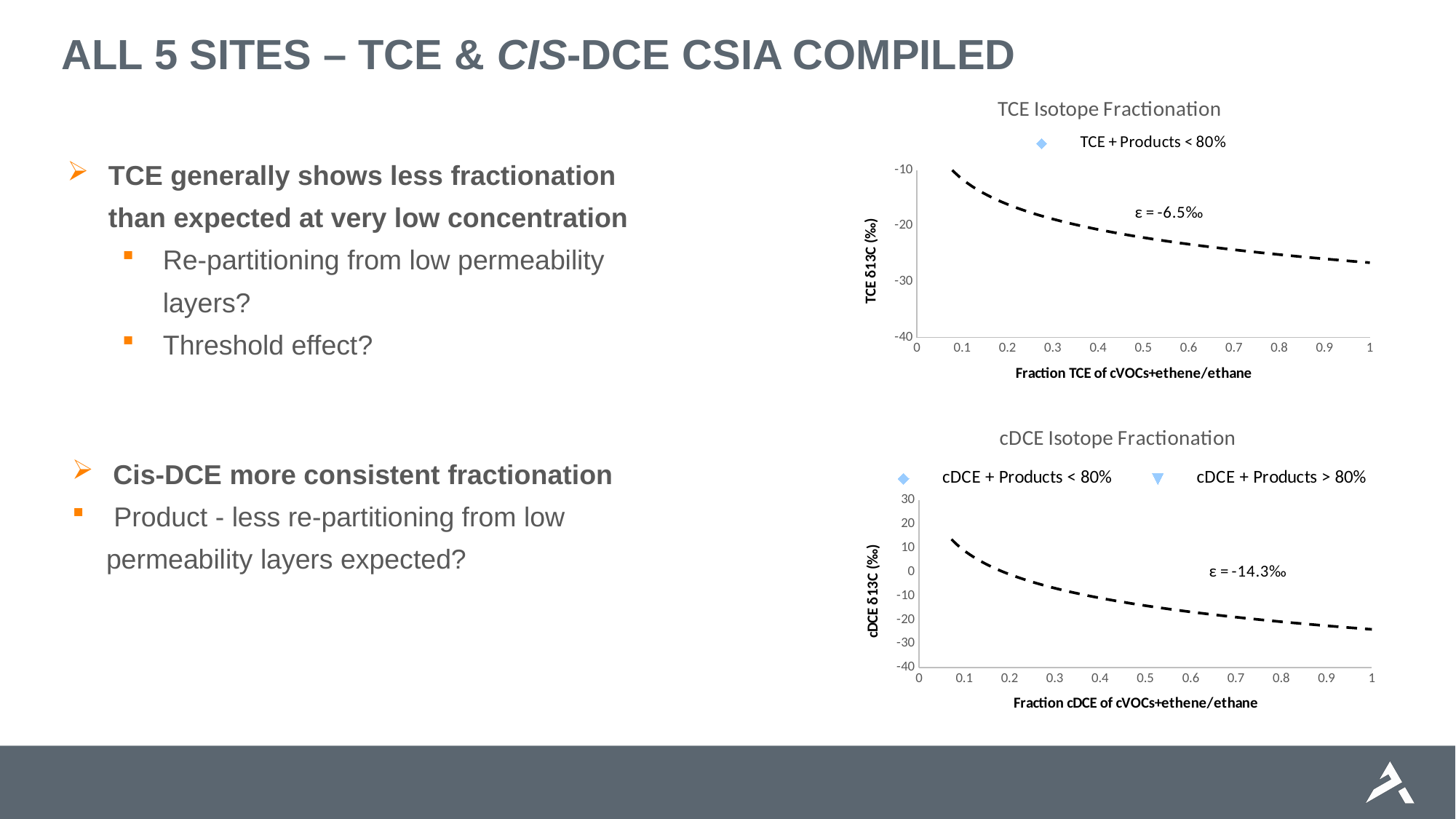
What enrichment factor (ε) is annotated on the 'TCE Isotope Fractionation' chart? ε = -6.5‰ In the 'cDCE Isotope Fractionation' chart, does the dashed trend line rise or fall along the x axis? fall How many series does the legend of the 'cDCE Isotope Fractionation' chart list? 2 In the 'cDCE Isotope Fractionation' chart, is the trend line value at a fraction of 1 greater or less than 0? less In the 'TCE Isotope Fractionation' chart, is the trend line value at a fraction of 1 greater or less than -20? less What enrichment factor (ε) is annotated on the 'cDCE Isotope Fractionation' chart? ε = -14.3‰ In the 'TCE Isotope Fractionation' chart, does the dashed trend line rise or fall as the fraction of TCE increases? fall What kind of chart is the 'TCE Isotope Fractionation' chart? scatter chart with a dashed trend line How many series does the legend of the 'TCE Isotope Fractionation' chart list? 1 In the 'cDCE Isotope Fractionation' chart, is the trend line value at a fraction of 0.1 greater or less than 0? greater